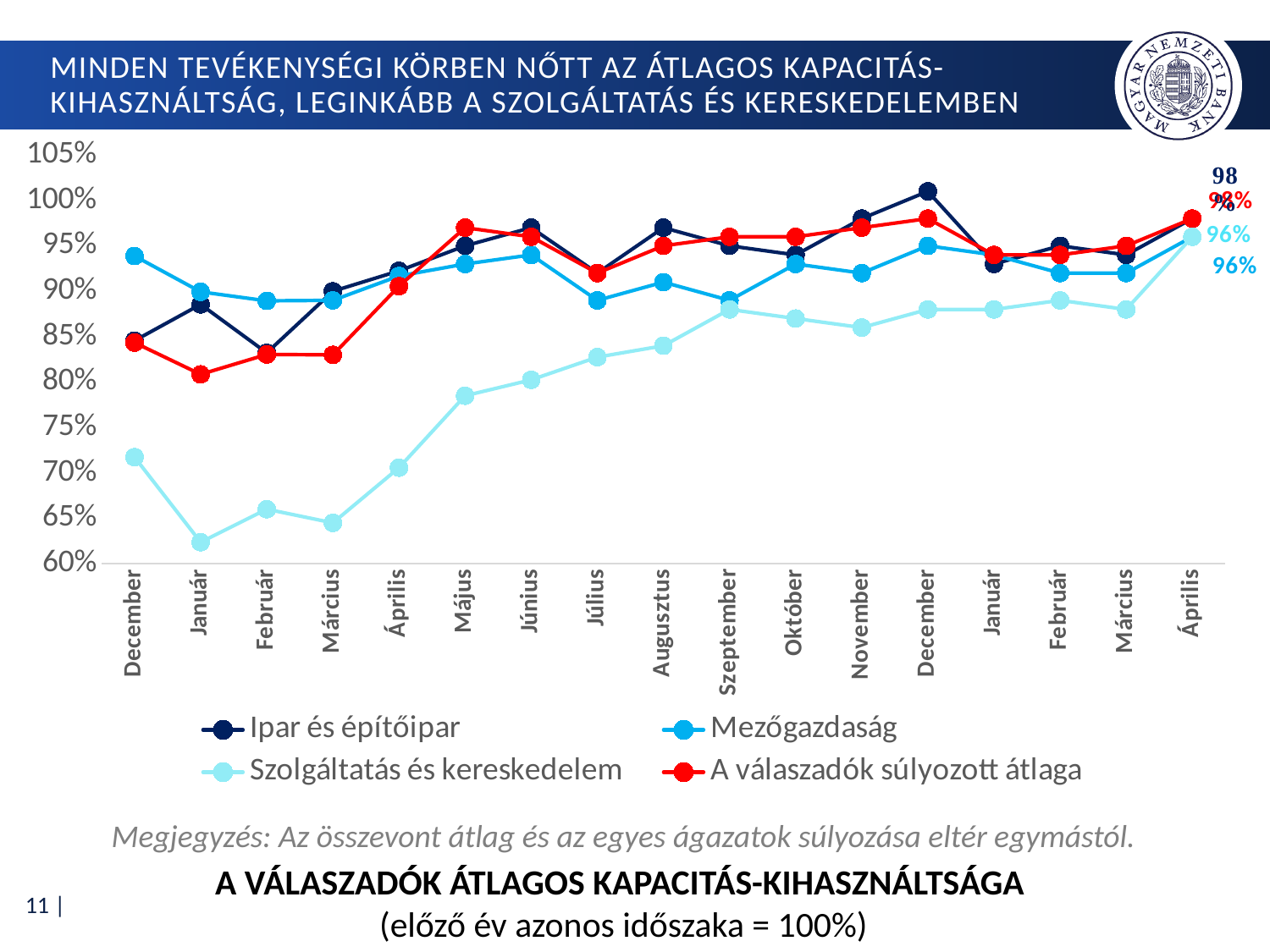
In the first December, which is larger: Mezőgazdaság or Szolgáltatás és kereskedelem? Mezőgazdaság What kind of chart is shown on the slide? line chart In which month is the Szolgáltatás és kereskedelem series at its lowest? Január (the first one) Is the value for Ipar és építőipar in the second December greater or less than 100%? greater How many months are shown along the x axis? 17 What is the value for A válaszadók súlyozott átlaga in the final Április? 98% In which month does the Ipar és építőipar series reach its highest value? December (the second one) What is the value for Ipar és építőipar in the final Április? 98% How many series does the legend list? 4 What is the value for Mezőgazdaság in the final Április? 96% Does the Szolgáltatás és kereskedelem series generally rise or fall from the first December to the final Április? rise Is the value for Szolgáltatás és kereskedelem in the first Január greater or less than 65%? less